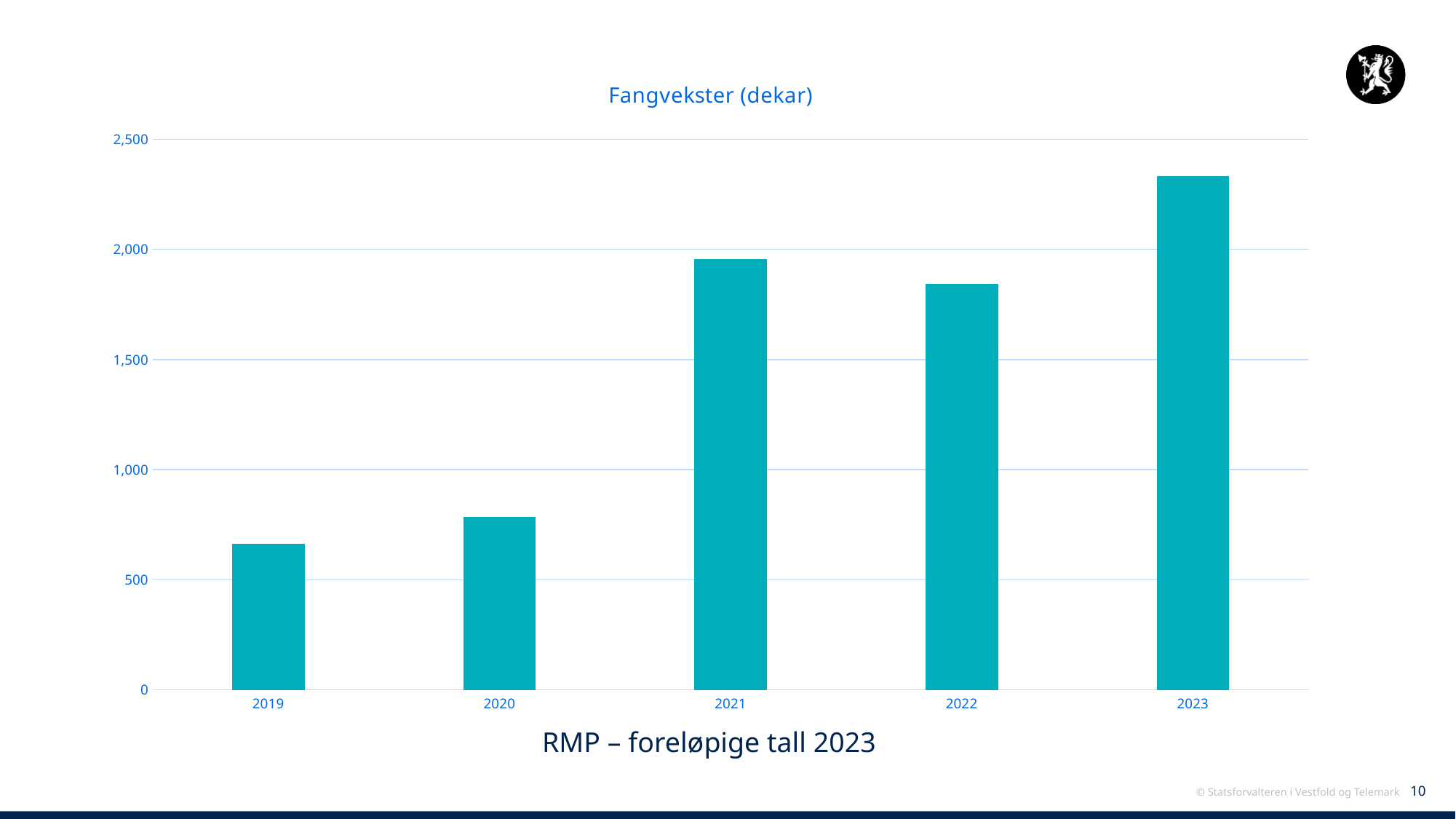
Is the value for 2021 greater or less than 1,500? greater Is the value for 2022 greater or less than 2,000? less Which is larger, the value for 2019 or the value for 2020? 2020 Is the value for 2020 greater or less than 500? greater Which is larger, the value for 2021 or the value for 2022? 2021 What kind of chart is shown on the slide? bar chart How many years are shown on the x axis of the chart? 5 Which year has the highest value in the chart? 2023 Which year has the lowest value in the chart? 2019 What is the title of the chart? Fangvekster (dekar)